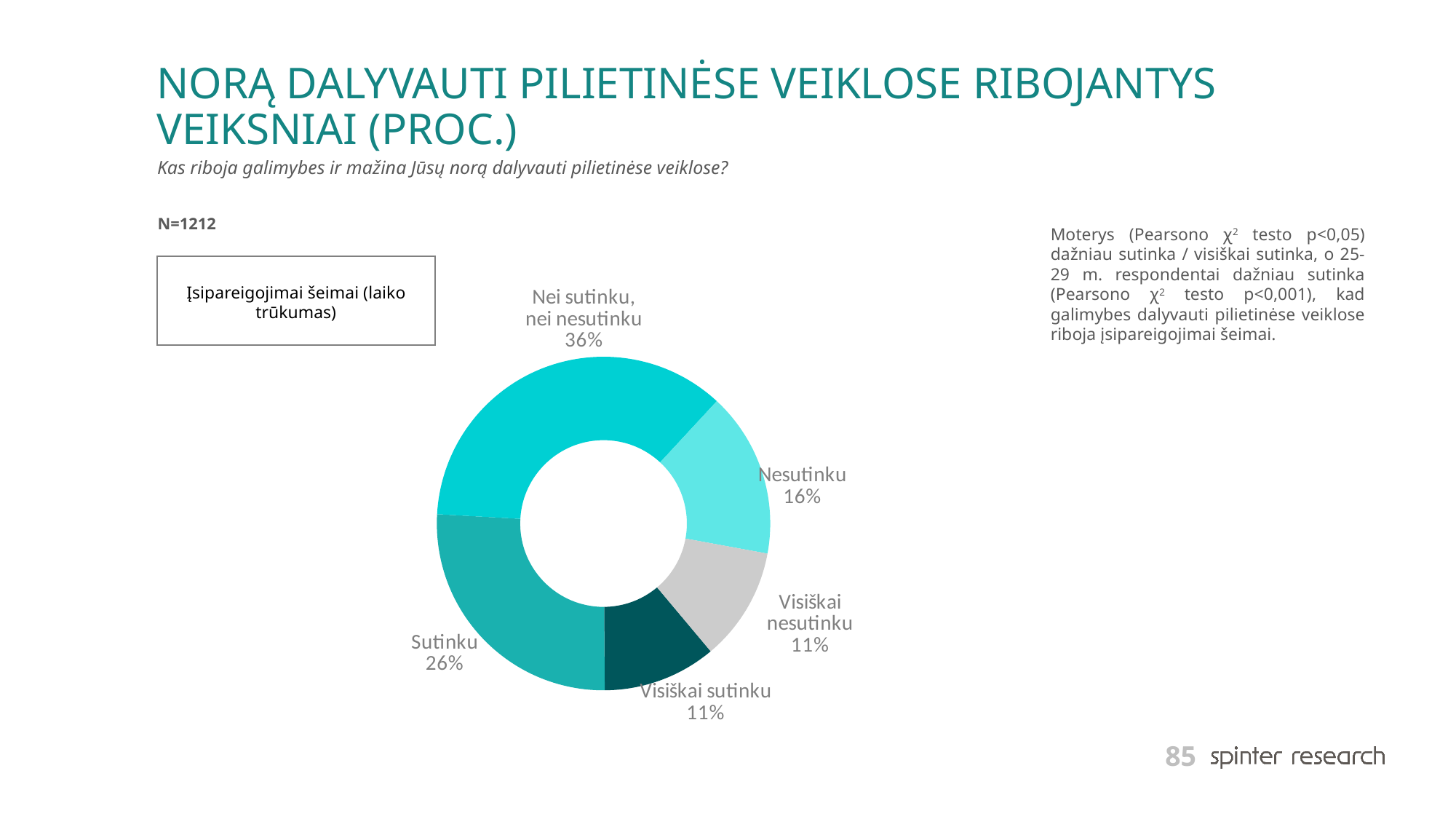
What percentage of respondents answered "Sutinku"? 26% What is the sample size (N) shown on the slide? N=1212 Which is larger, the share for "Sutinku" or the share for "Nesutinku"? Sutinku What is the combined share of "Sutinku" and "Visiškai sutinku"? 37% What is the difference in percentage points between "Sutinku" and "Nesutinku"? 10 What percentage of respondents answered "Nesutinku"? 16% What factor is named in the box to the left of the chart? Įsipareigojimai šeimai (laiko trūkumas) What percentage of respondents answered "Nei sutinku, nei nesutinku"? 36% How many response categories are shown in the chart? 5 What type of chart is shown on the slide? Pie chart (doughnut) What percentage of respondents answered "Visiškai sutinku"? 11% Which response category has the largest share of the pie? Nei sutinku, nei nesutinku